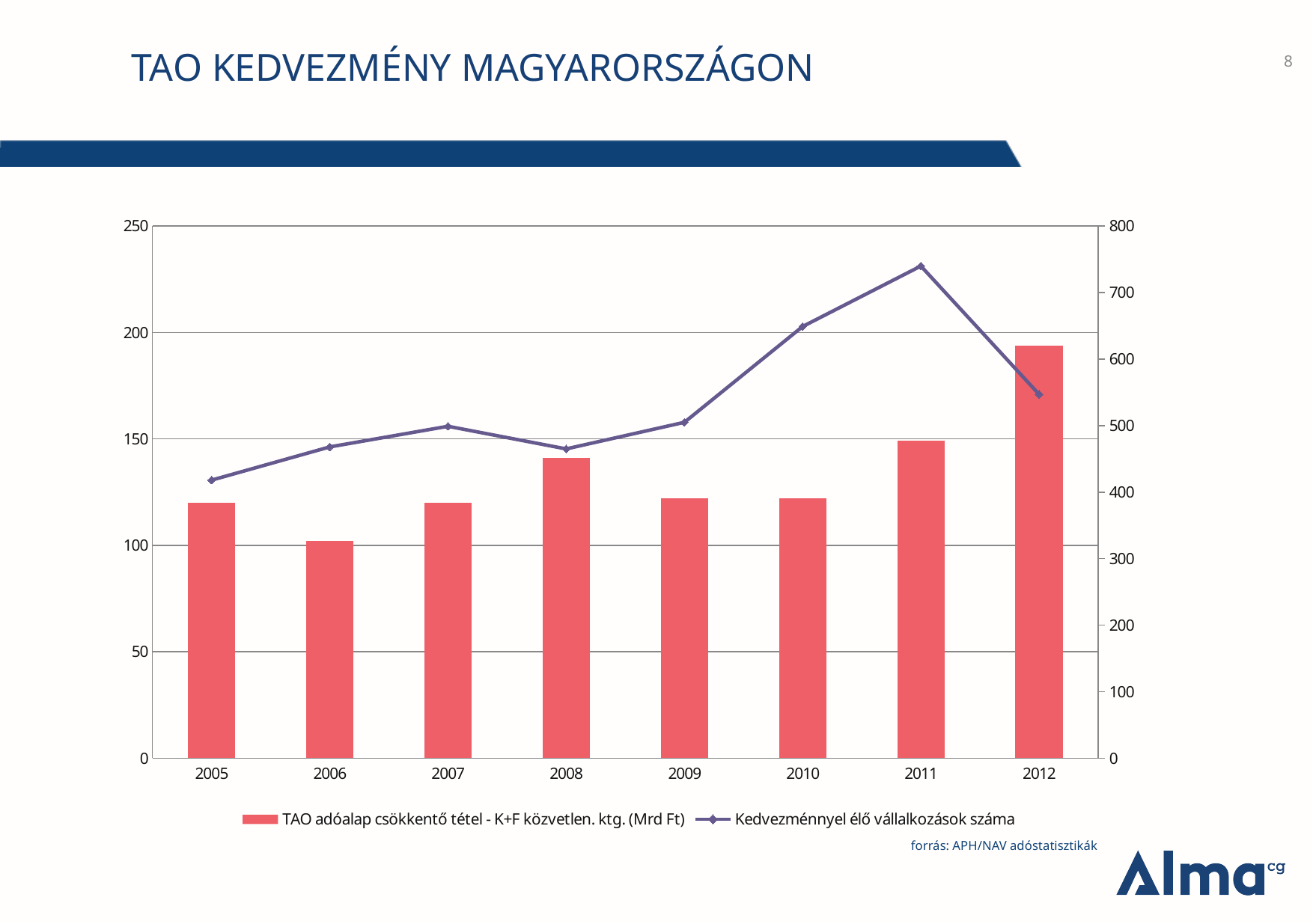
Which year has the shortest bar for 'TAO adóalap csökkentő tétel - K+F közvetlen. ktg. (Mrd Ft)'? 2006 Is the bar value for 2006 greater or less than 150? less In which year does the line 'Kedvezménnyel élő vállalkozások száma' reach its highest point? 2011 How many years are shown on the x axis? 8 In which year is the line 'Kedvezménnyel élő vállalkozások száma' at its lowest point? 2005 Is the value of 'Kedvezménnyel élő vállalkozások száma' for 2005 greater or less than 500? less Which year has the tallest bar for 'TAO adóalap csökkentő tétel - K+F közvetlen. ktg. (Mrd Ft)'? 2012 How many series does the legend list? 2 Is the bar value for 2012 greater or less than 150? greater Does the line 'Kedvezménnyel élő vállalkozások száma' rise or fall from 2009 to 2011? rise Which year has the larger bar, 2008 or 2006? 2008